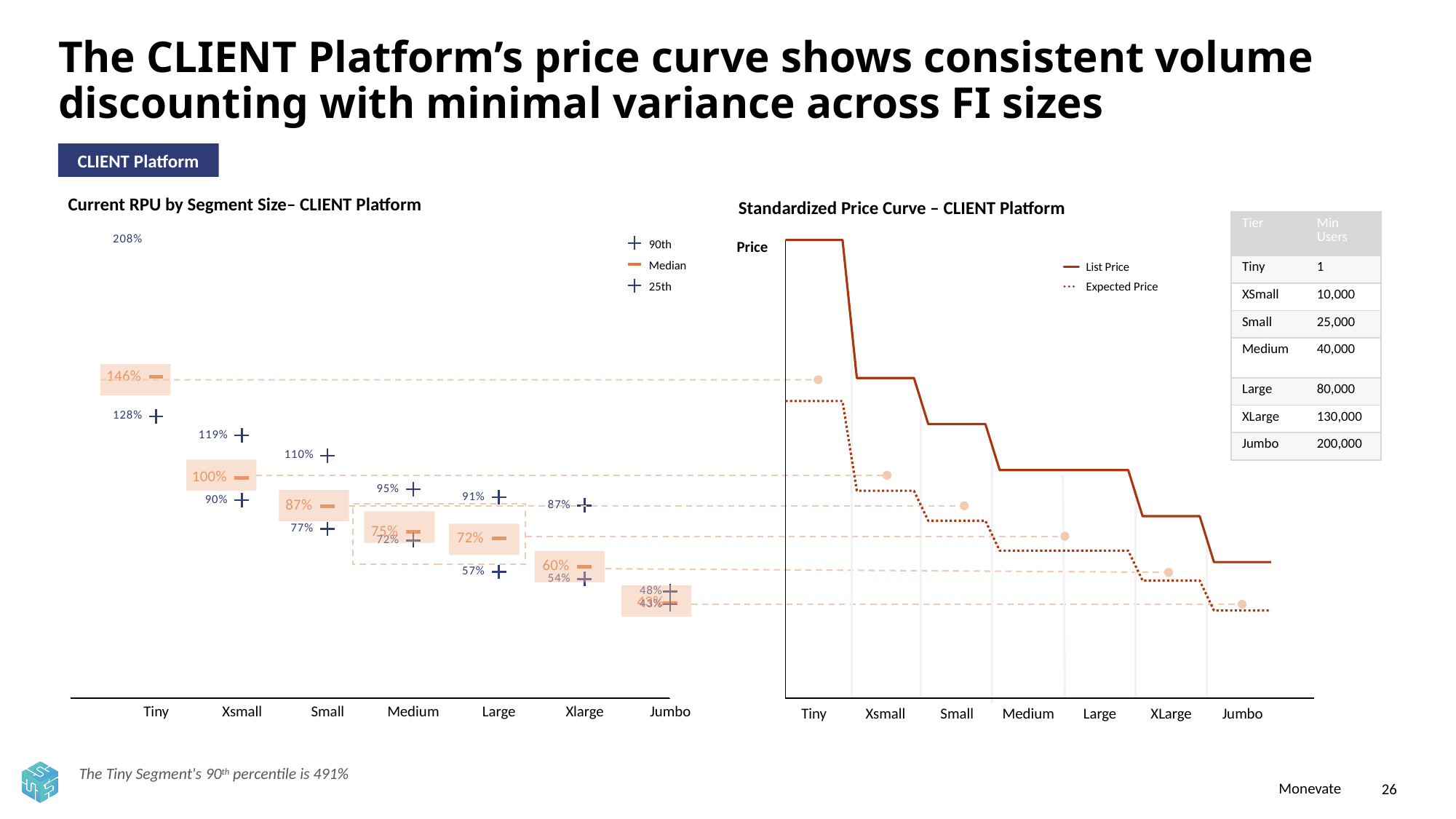
In the Current RPU by Segment Size chart, what is the 25th percentile value for the Small segment? 77% How many segment categories are shown on the x axis of the Current RPU by Segment Size chart? 7 In the Current RPU by Segment Size chart, which has the higher 90th percentile value, Small or Medium? Small In the Current RPU by Segment Size chart, which segment has the highest Median value? Tiny In the Current RPU by Segment Size chart, what is the Median value for the Tiny segment? 146% What kind of chart is the Standardized Price Curve chart? Line chart In the Current RPU by Segment Size chart, what is the Median value for the Xlarge segment? 60% In the Standardized Price Curve chart, does the List Price rise or fall as you move from Tiny to Jumbo? Fall In the Current RPU by Segment Size chart, what is the difference between the Median values for Tiny and Xsmall? 46 percentage points How many series does the legend of the Current RPU by Segment Size chart list? 3 In the Current RPU by Segment Size chart, what is the 90th percentile value for the Tiny segment? 208% In the Current RPU by Segment Size chart, what is the 90th percentile value for the Large segment? 91%